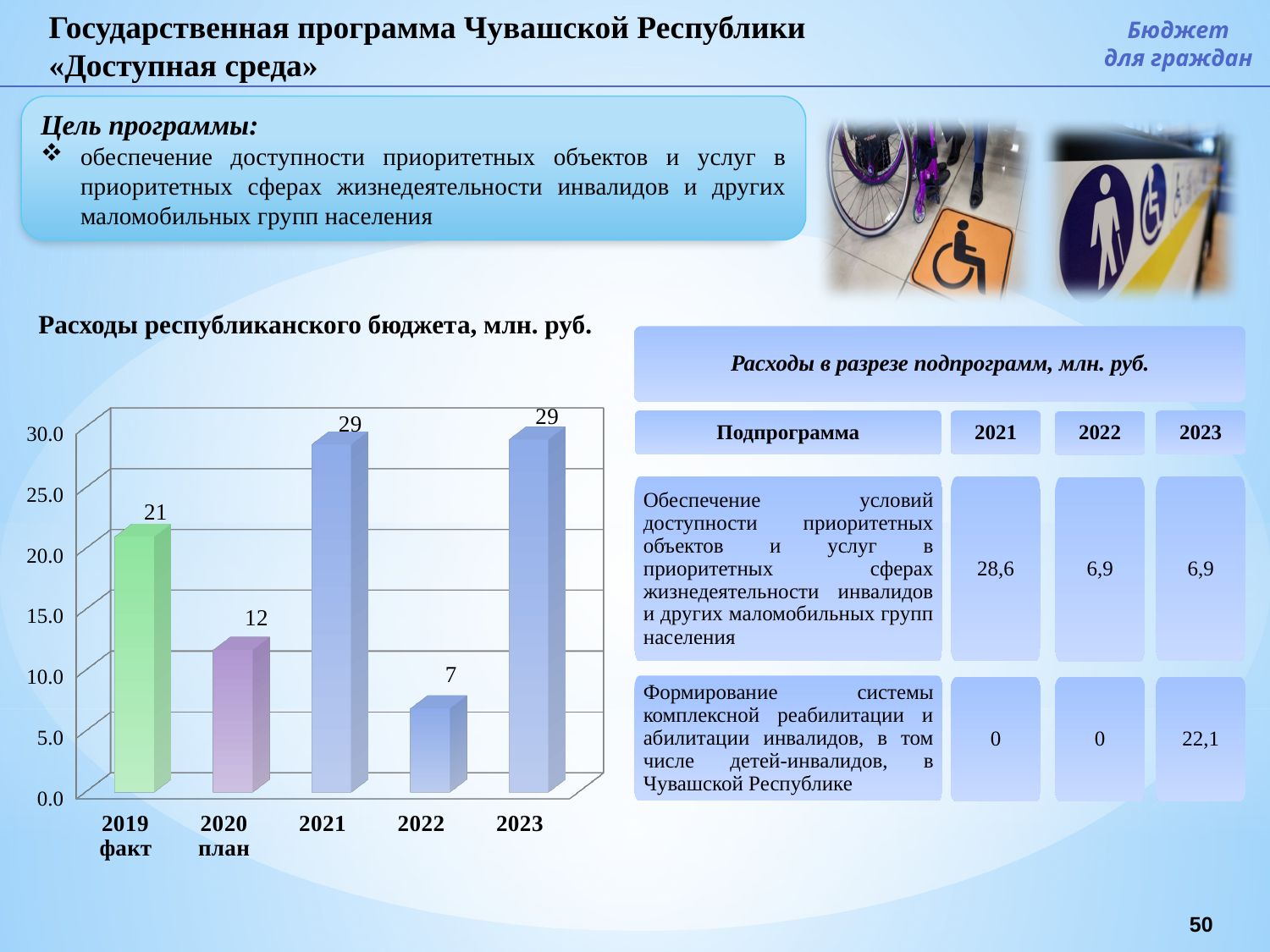
What is the value for 2022 in the chart? 7 Which year has the lowest value in the chart? 2022 What is the value for 2020 план in the chart? 12 Is the value for 2022 greater or less than 10.0? less How many categories are shown on the x axis of the chart? 5 What is the title of the chart on the slide? Расходы республиканского бюджета, млн. руб. What kind of chart is shown on the slide? bar chart What is the difference between the values for 2021 and 2022? 22 Which is larger, the value for 2019 факт or the value for 2020 план? 2019 факт What is the value for 2019 факт in the chart 'Расходы республиканского бюджета, млн. руб.'? 21 What is the value for 2023 in the chart? 29 What is the difference between the values for 2019 факт and 2020 план? 9